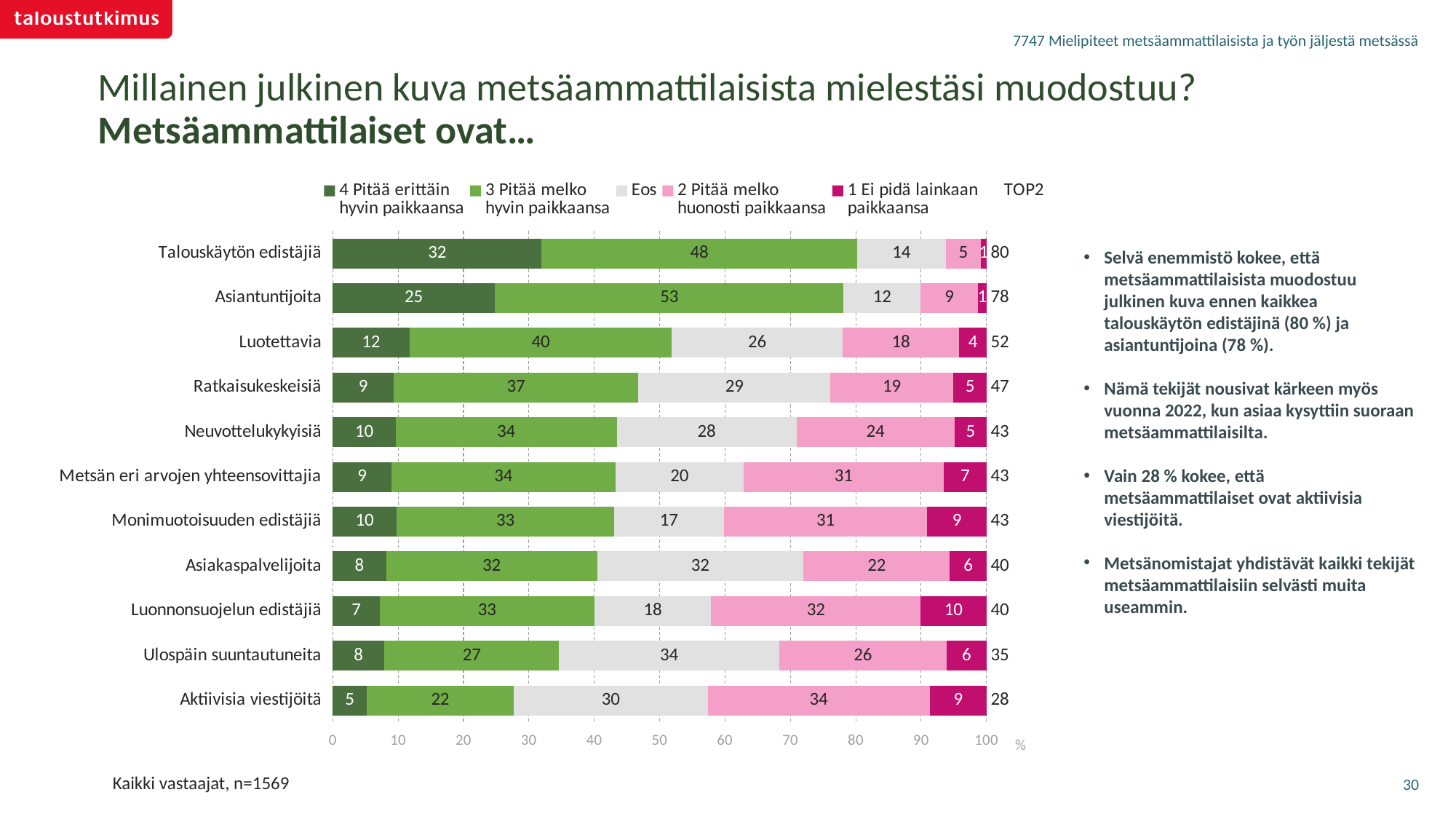
How many series does the chart legend list? 6 What is the TOP2 value for 'Luotettavia'? 52 What is the value of '4 Pitää erittäin hyvin paikkaansa' for 'Talouskäytön edistäjiä'? 32 What kind of chart is shown on the slide? stacked bar chart What is the 'Eos' value for 'Ulospäin suuntautuneita'? 34 What is the total of the '4 Pitää erittäin hyvin paikkaansa' and '3 Pitää melko hyvin paikkaansa' segments for 'Neuvottelukykyisiä'? 44 How many categories (statements) are plotted on the chart? 11 What is the value of '3 Pitää melko hyvin paikkaansa' for 'Asiantuntijoita'? 53 Which category has the lowest TOP2 value? Aktiivisia viestijöitä What is the difference between the TOP2 values of 'Talouskäytön edistäjiä' and 'Asiantuntijoita'? 2 Which category has the highest TOP2 value? Talouskäytön edistäjiä Which has a larger '1 Ei pidä lainkaan paikkaansa' value: 'Luonnonsuojelun edistäjiä' or 'Asiakaspalvelijoita'? Luonnonsuojelun edistäjiä